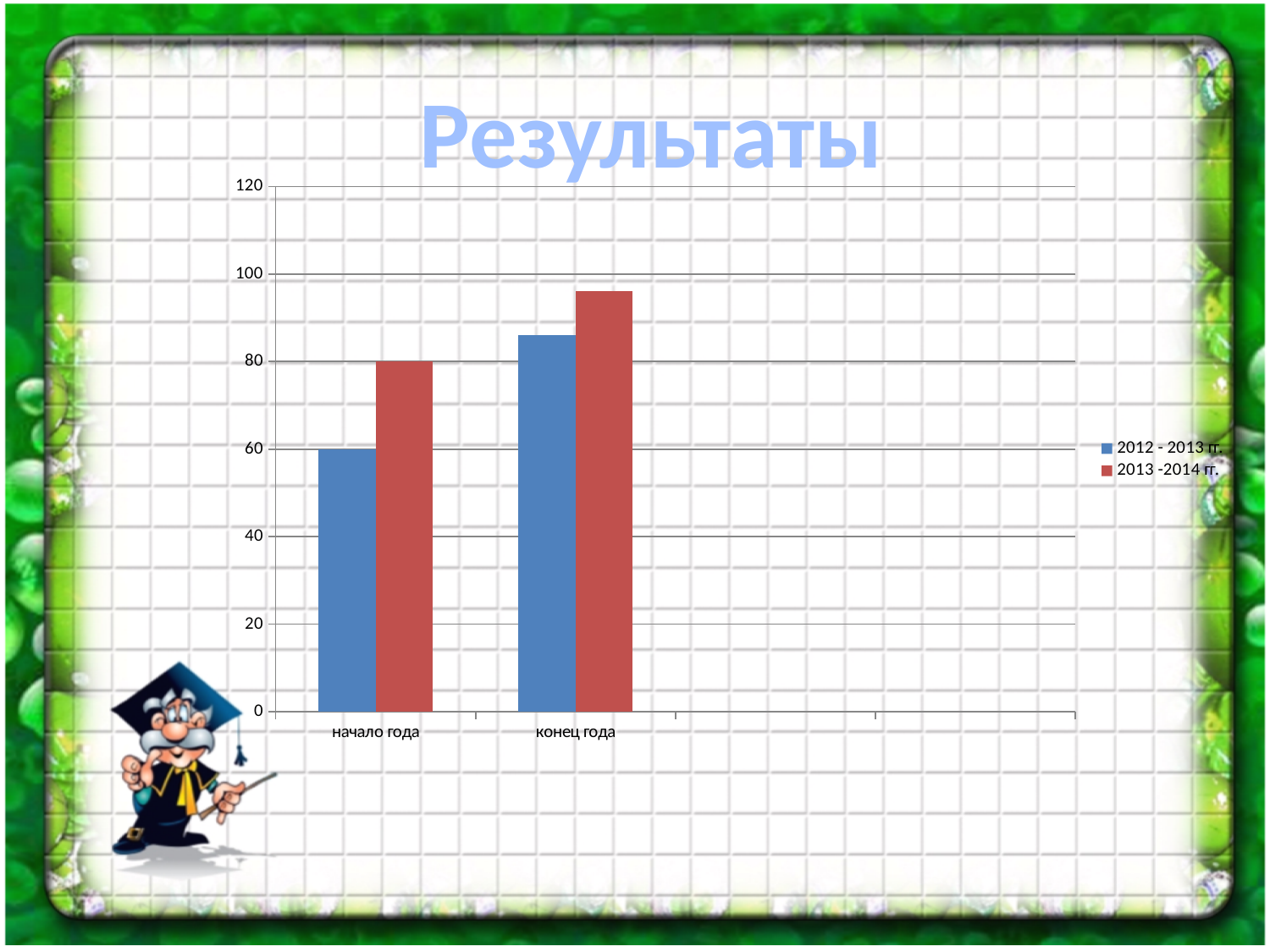
How many categories are shown on the x axis? 2 Which series has the higher value at конец года? 2013 -2014 гг. How many series does the legend list? 2 What is the difference between the 2013 -2014 гг. and 2012 - 2013 гг. values at начало года? 20 Is the value for 2013 -2014 гг. at конец года greater or less than 100? less Which bar is the shortest in the chart? 2012 - 2013 гг. at начало года Is the value for 2012 - 2013 гг. at конец года greater or less than 80? greater What is the value for 2013 -2014 гг. at начало года? 80 What is the title of the chart? Результаты Which bar is the tallest in the chart? 2013 -2014 гг. at конец года What kind of chart is shown on the slide? bar chart What is the value for 2012 - 2013 гг. at начало года? 60